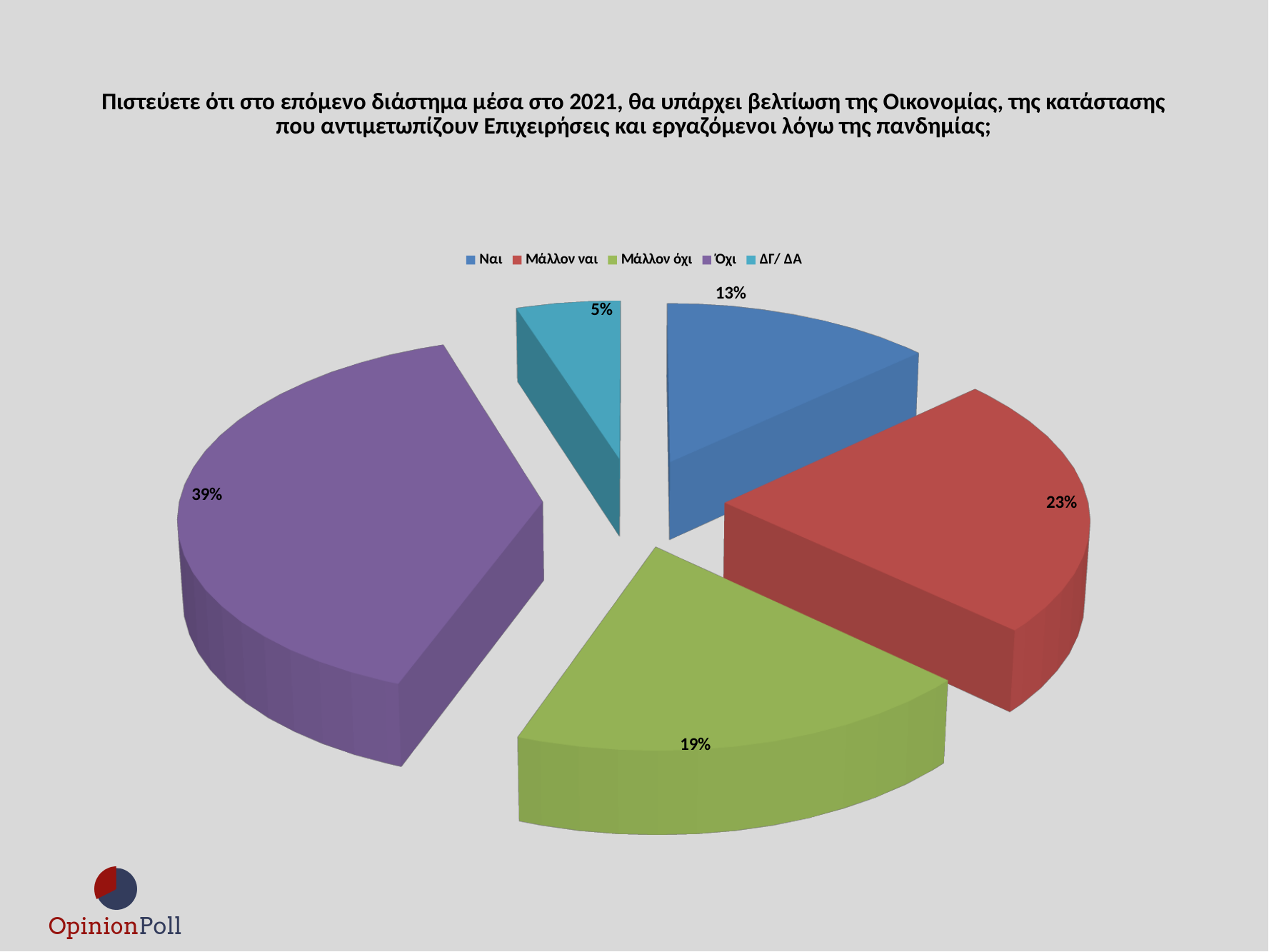
What percentage of respondents answered "Μάλλον όχι"? 19% How many categories does the pie chart show? 5 Which response has the largest share of the pie? Όχι What percentage of respondents answered "ΔΓ/ ΔΑ"? 5% What kind of chart is shown on the slide? Pie chart Which response has the smallest share of the pie? ΔΓ/ ΔΑ What is the difference in percentage points between "Όχι" and "Ναι"? 26 What colour is the slice for "Όχι"? Purple What percentage of respondents answered "Ναι"? 13% What percentage of respondents answered "Όχι"? 39% What percentage of respondents answered "Μάλλον ναι"? 23% Which is larger, the share for "Μάλλον ναι" or the share for "Μάλλον όχι"? Μάλλον ναι